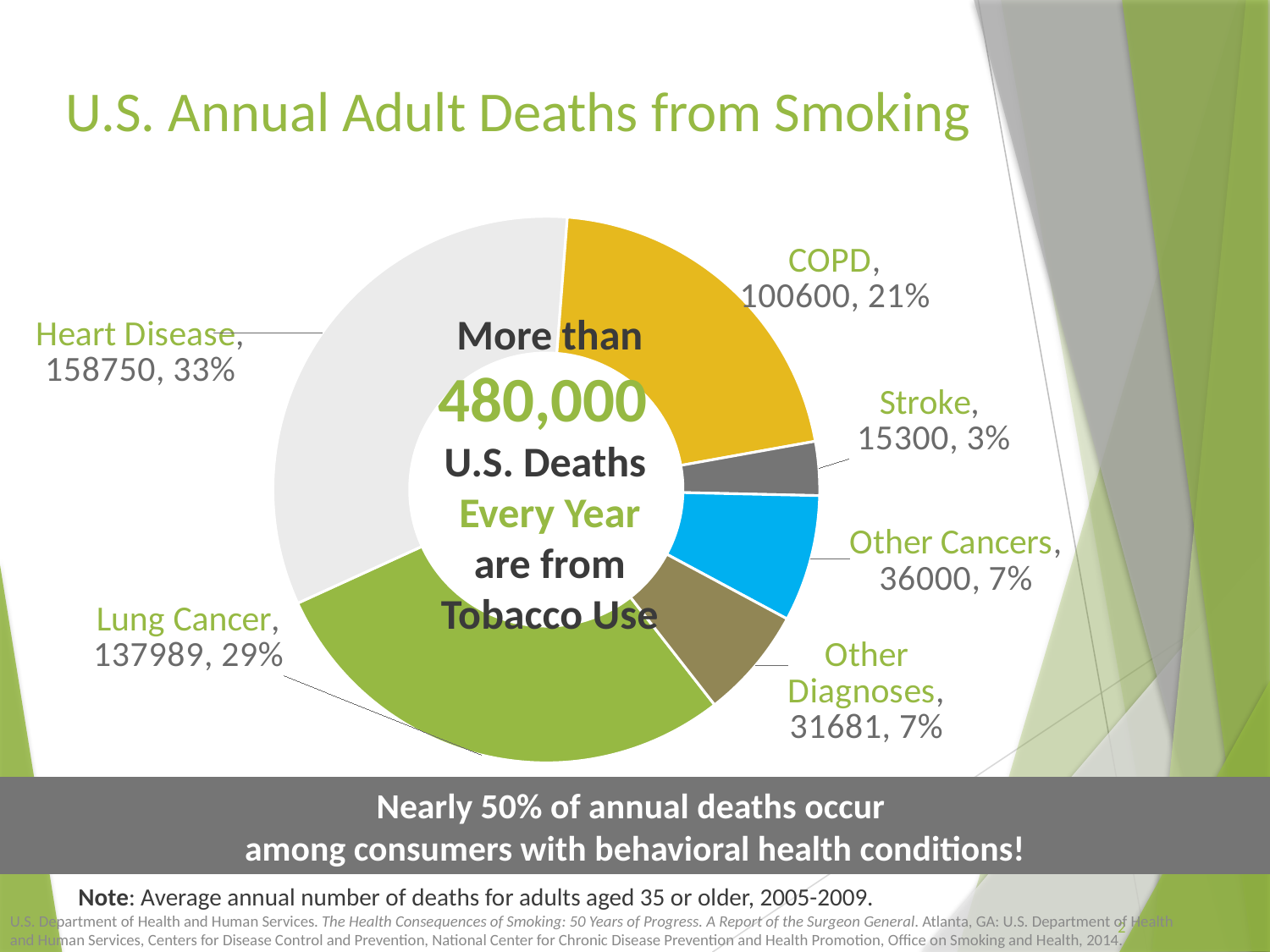
What is the number of deaths shown for Stroke? 15300 What kind of chart is shown on the slide? doughnut chart What is the difference in deaths between Heart Disease and Lung Cancer? 20761 What percentage share of deaths does COPD represent? 21% What is the number of deaths shown for COPD? 100600 How many deaths are attributed to Heart Disease in the chart? 158750 Which category accounts for the largest share of deaths in the chart? Heart Disease What is the number of deaths shown for Lung Cancer? 137989 Which category accounts for the smallest share of deaths in the chart? Stroke How many categories are shown in the chart? 6 What percentage share of deaths does Lung Cancer represent? 29% Which has more deaths, Other Cancers or Other Diagnoses? Other Cancers